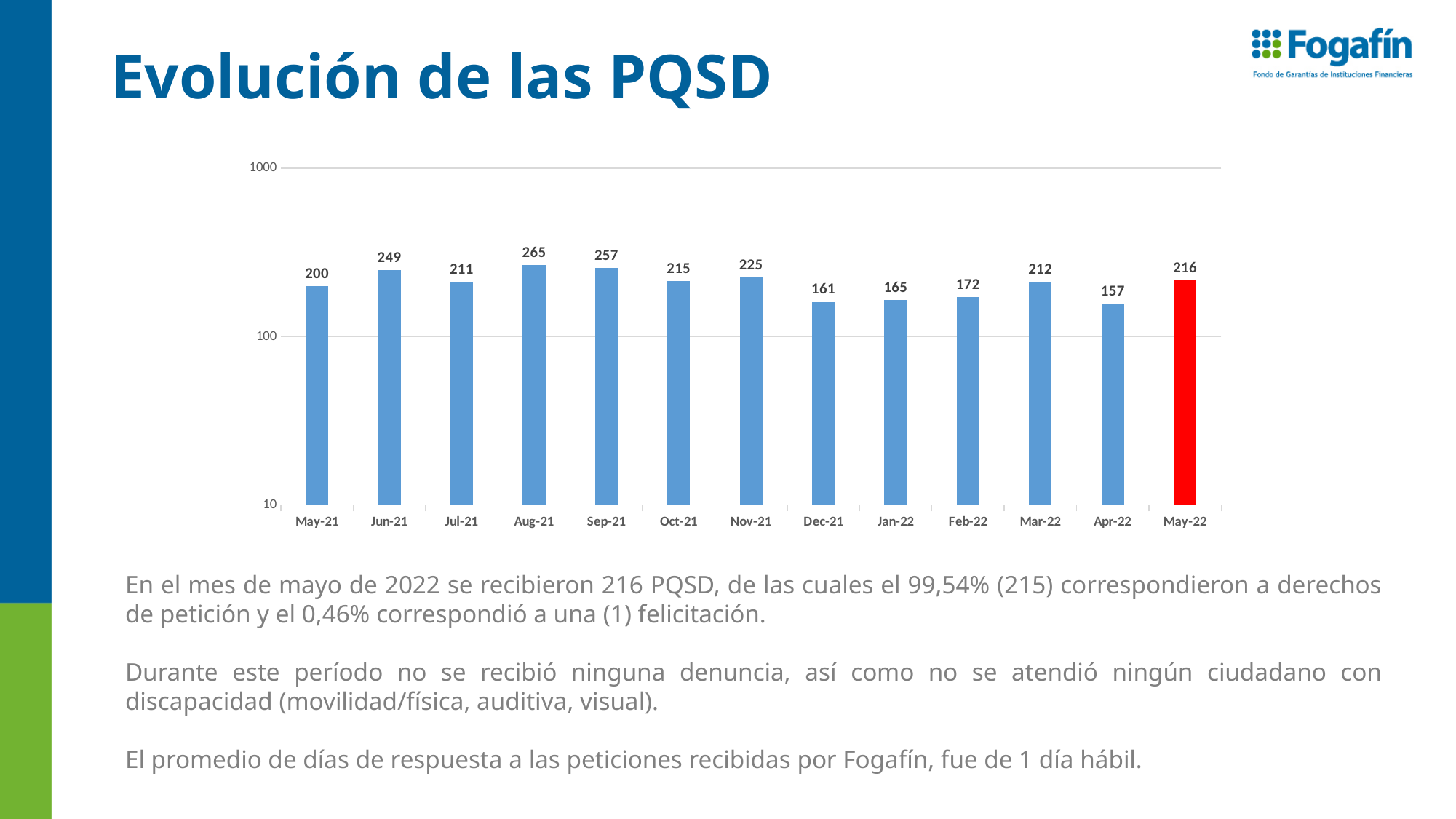
How many months are shown on the x axis? 13 Which month has the lowest value? Apr-22 Do the values rise or fall from Nov-21 to Dec-21? fall What is the difference between the values for Aug-21 and Apr-22? 108 Which month has the highest value? Aug-21 What kind of chart is shown on the slide? bar chart Is the value for Feb-22 greater or less than 100? greater Which bar is coloured red instead of blue? May-22 What is the value for May-22? 216 What is the value for Dec-21? 161 What is the value for Aug-21? 265 Which is larger, the value for Jun-21 or the value for Sep-21? Sep-21